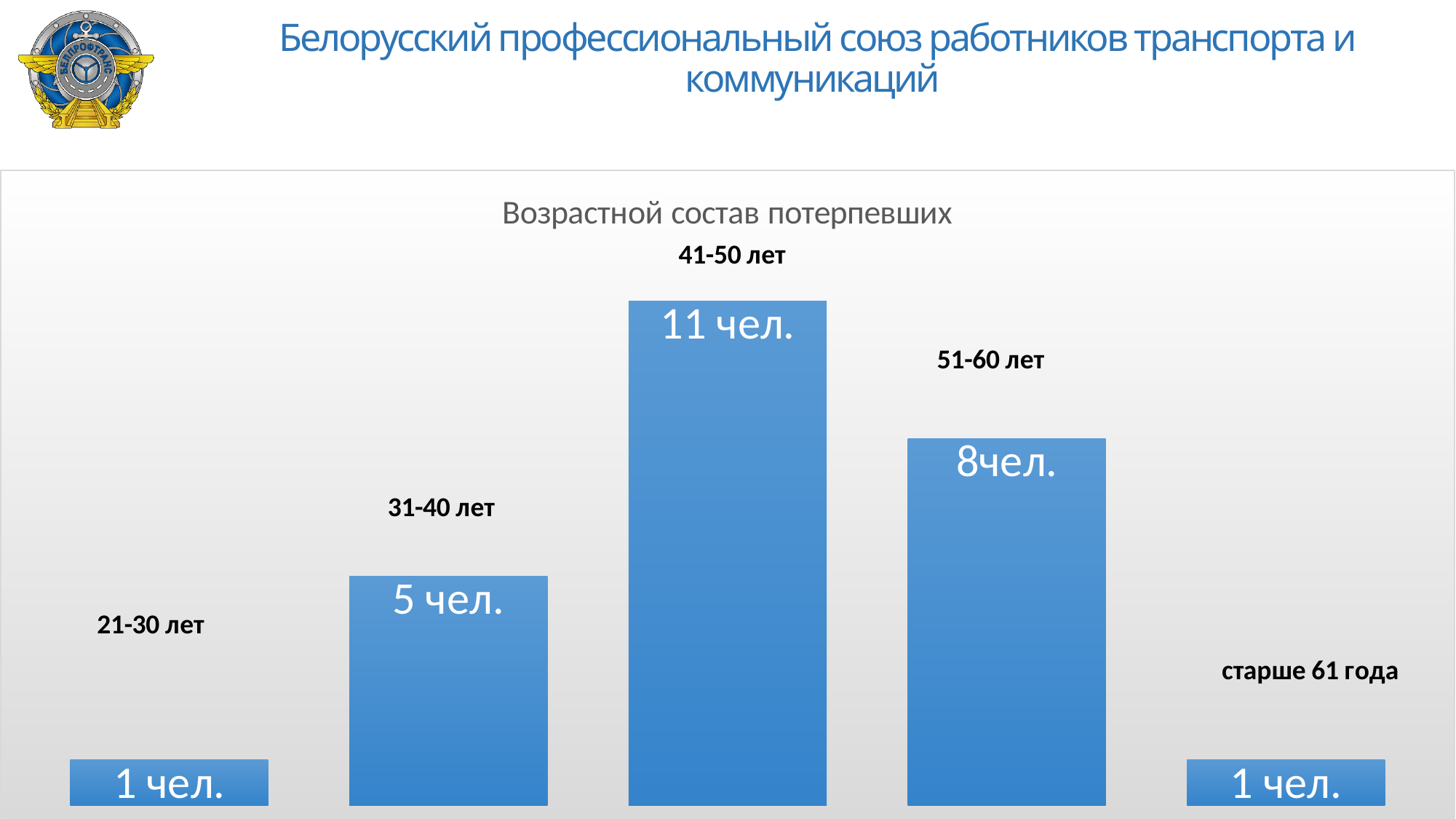
How many age categories are shown in the chart? 5 What is the total of all the values shown in the chart? 26 чел. Which age category has the highest value? 41-50 лет What is the value for the 21-30 лет category? 1 чел. What is the value for the 31-40 лет category? 5 чел. What is the title of the chart? Возрастной состав потерпевших What is the difference between the values for 31-40 лет and 21-30 лет? 4 чел. What kind of chart is shown on the slide? bar chart What is the value for the 41-50 лет category? 11 чел. What is the difference between the values for 41-50 лет and 51-60 лет? 3 чел. Which is larger, the value for 31-40 лет or the value for 51-60 лет? 51-60 лет What is the value for the 51-60 лет category? 8чел.